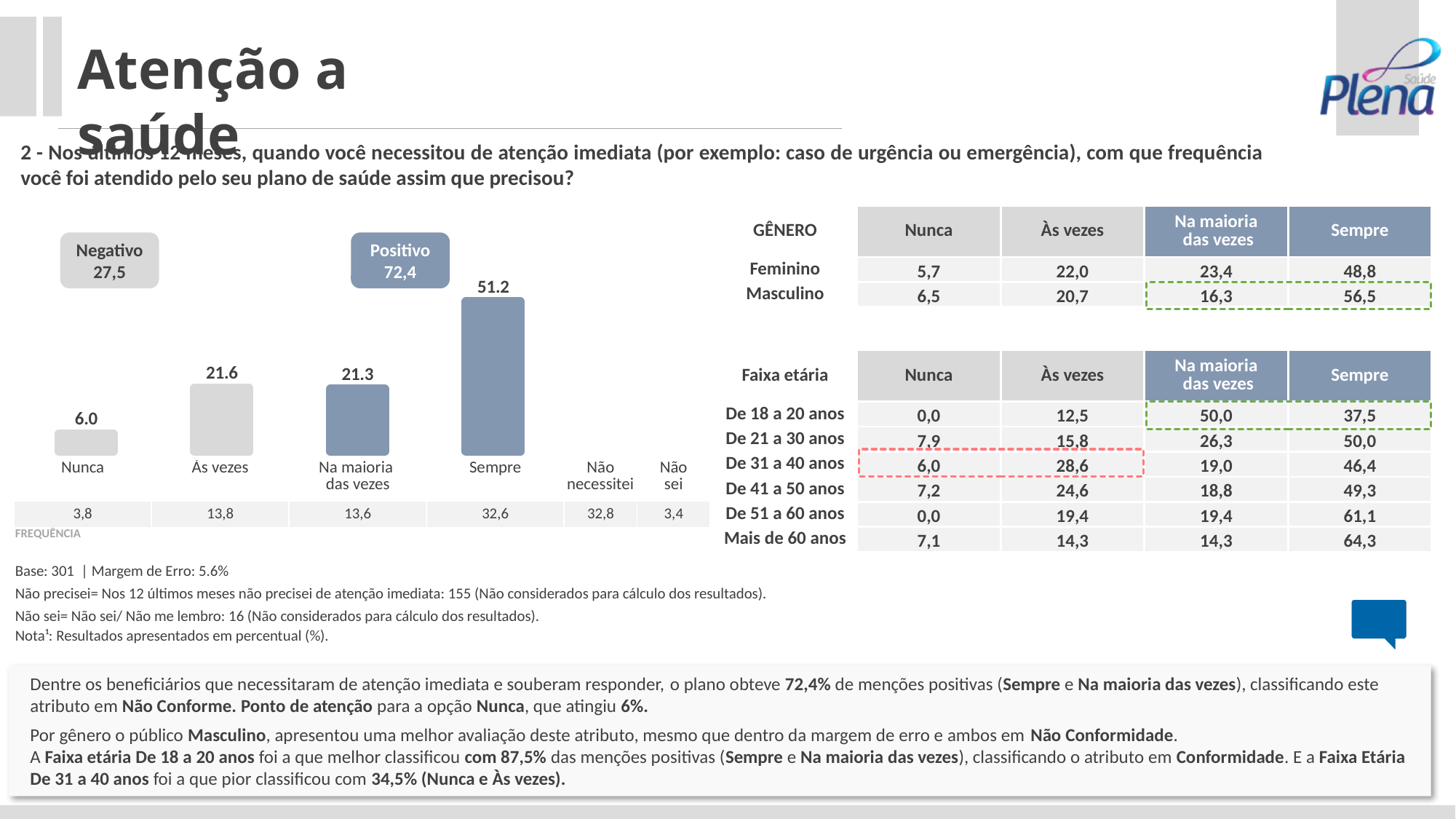
Which category has the lowest bar in the bar chart? Nunca What is the difference between the 'Sempre' bar and the 'Nunca' bar in the bar chart? 45.2 What kind of chart is shown on the left of the slide? Bar chart What is the value shown for the 'Às vezes' bar in the bar chart? 21.6 What is the value shown for the 'Na maioria das vezes' bar in the bar chart? 21.3 Which category has the highest bar in the bar chart? Sempre What is the value shown for the 'Sempre' bar in the bar chart? 51.2 How many bars are plotted in the bar chart? 4 Which bar is larger in the bar chart, 'Às vezes' or 'Na maioria das vezes'? Às vezes What value is shown in the 'Negativo' label above the bar chart? 27,5 What is the value shown for the 'Nunca' bar in the bar chart? 6.0 What value is shown in the 'Positivo' label above the bar chart? 72,4